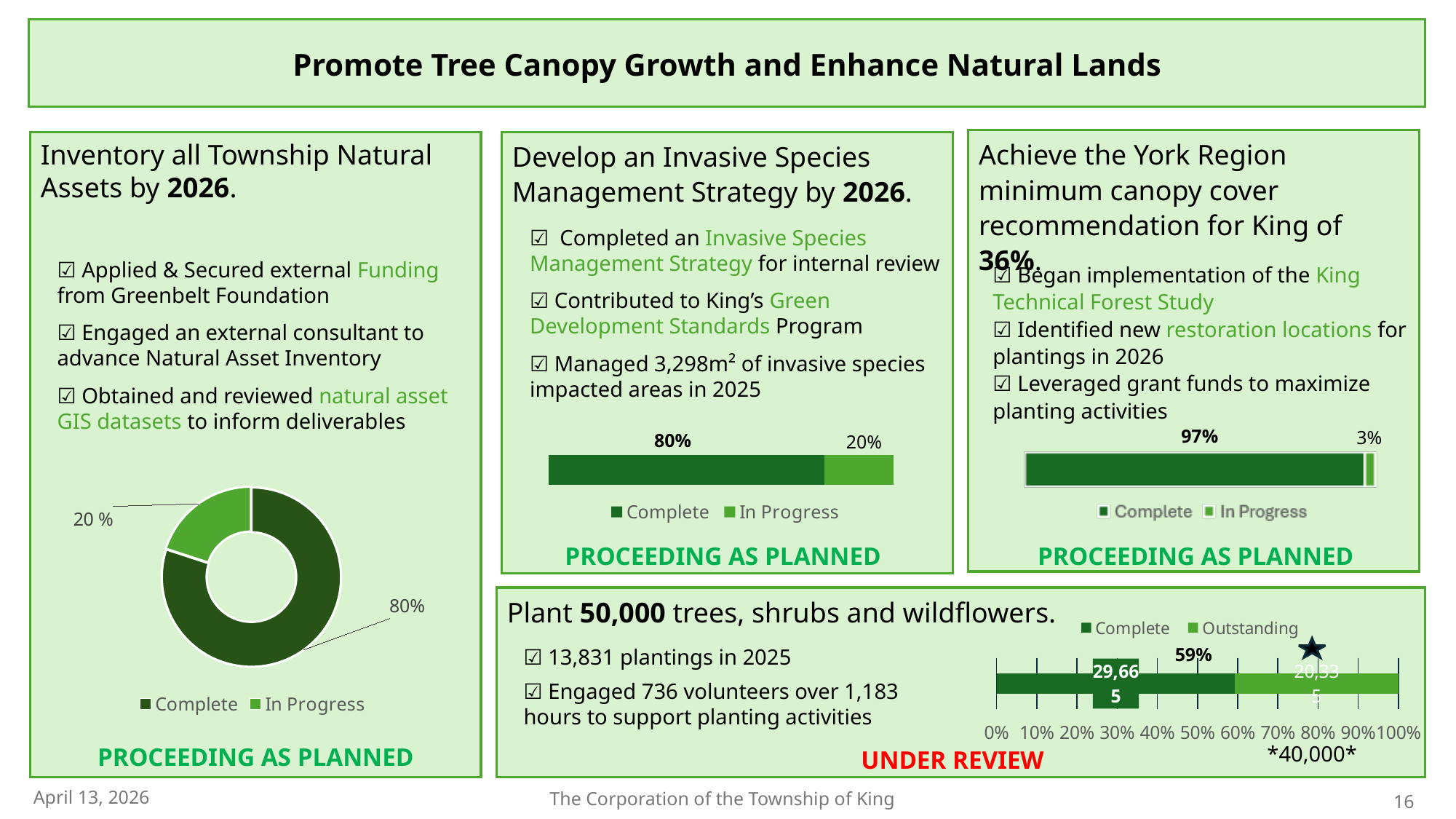
What are the two legend entries for the chart in the 'Plant 50,000 trees, shrubs and wildflowers' panel? Complete and Outstanding How many series does the legend list for the chart in the 'Achieve the York Region minimum canopy cover' panel? 2 In the chart in the 'Plant 50,000 trees, shrubs and wildflowers' panel, what is the total of the Complete and Outstanding segments? 50,000 In the chart in the 'Plant 50,000 trees, shrubs and wildflowers' panel, what is the value for Outstanding? 20,335 What kind of chart is shown in the 'Plant 50,000 trees, shrubs and wildflowers' panel? bar chart In the chart in the 'Plant 50,000 trees, shrubs and wildflowers' panel, what is the value for Complete? 29,665 What kind of chart is shown in the 'Inventory all Township Natural Assets by 2026' panel? doughnut chart In the chart in the 'Develop an Invasive Species Management Strategy by 2026' panel, which is larger, Complete or In Progress? Complete In the chart in the 'Achieve the York Region minimum canopy cover' panel, what is the difference between the Complete and In Progress values? 94% In the chart in the 'Develop an Invasive Species Management Strategy by 2026' panel, what is the value for In Progress? 20% In the donut chart in the 'Inventory all Township Natural Assets by 2026' panel, what percentage is labelled as Complete? 80% In the chart in the 'Achieve the York Region minimum canopy cover' panel, what is the value for Complete? 97%